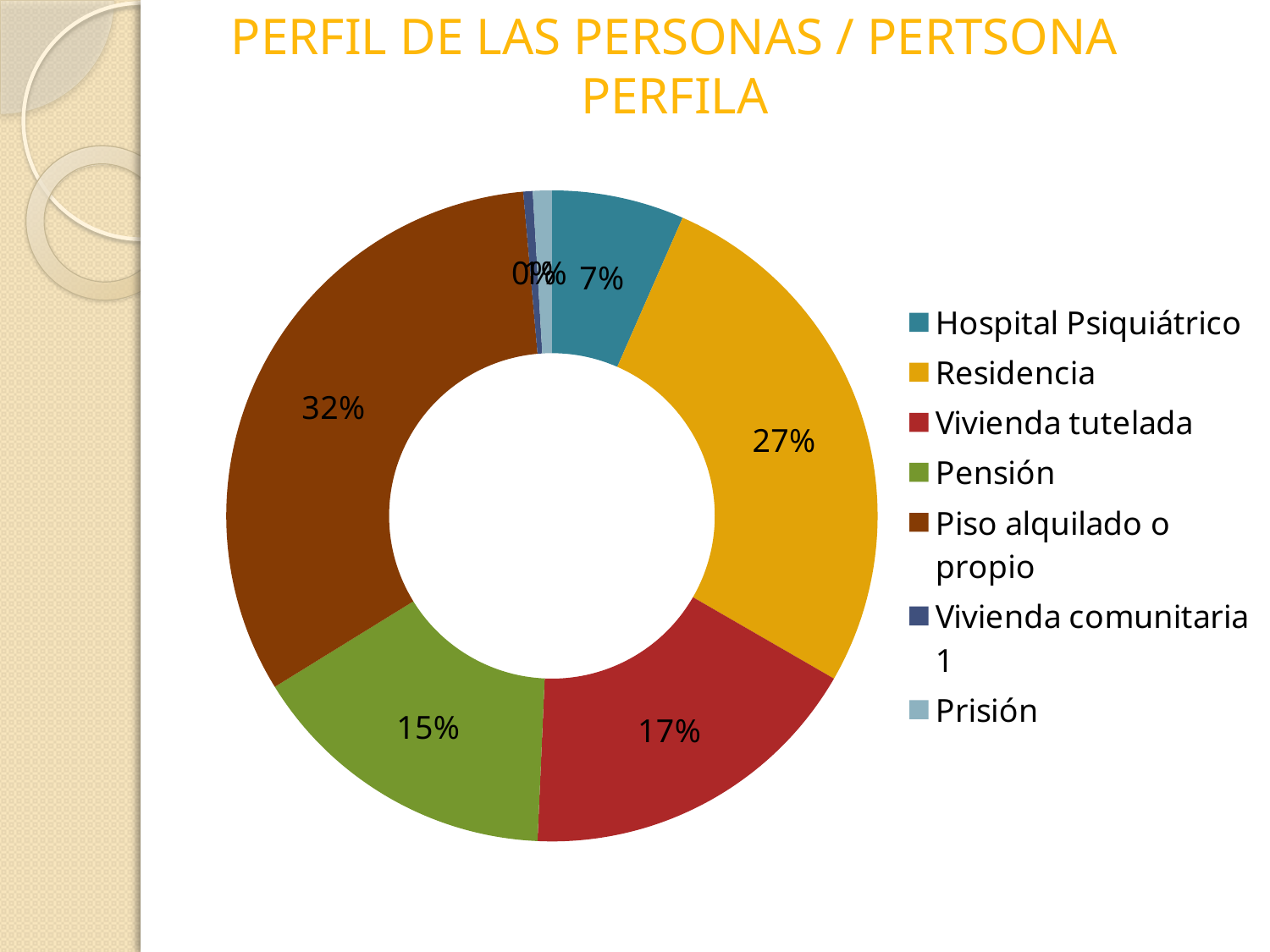
What share of the pie does Residencia represent? 27% What is the value for Pensión? 15% What kind of chart is shown on the slide? Pie chart (doughnut) How many categories does the legend list? 7 What percentage is shown for Vivienda tutelada? 17% What is the value for Hospital Psiquiátrico? 7% Which category has the largest share of the pie? Piso alquilado o propio What is the difference in percentage points between Vivienda tutelada and Pensión? 2 What colour is the Residencia slice? Yellow Which is larger, Residencia or Vivienda tutelada? Residencia What is the difference in percentage points between Piso alquilado o propio and Residencia? 5 What percentage is shown for Piso alquilado o propio? 32%